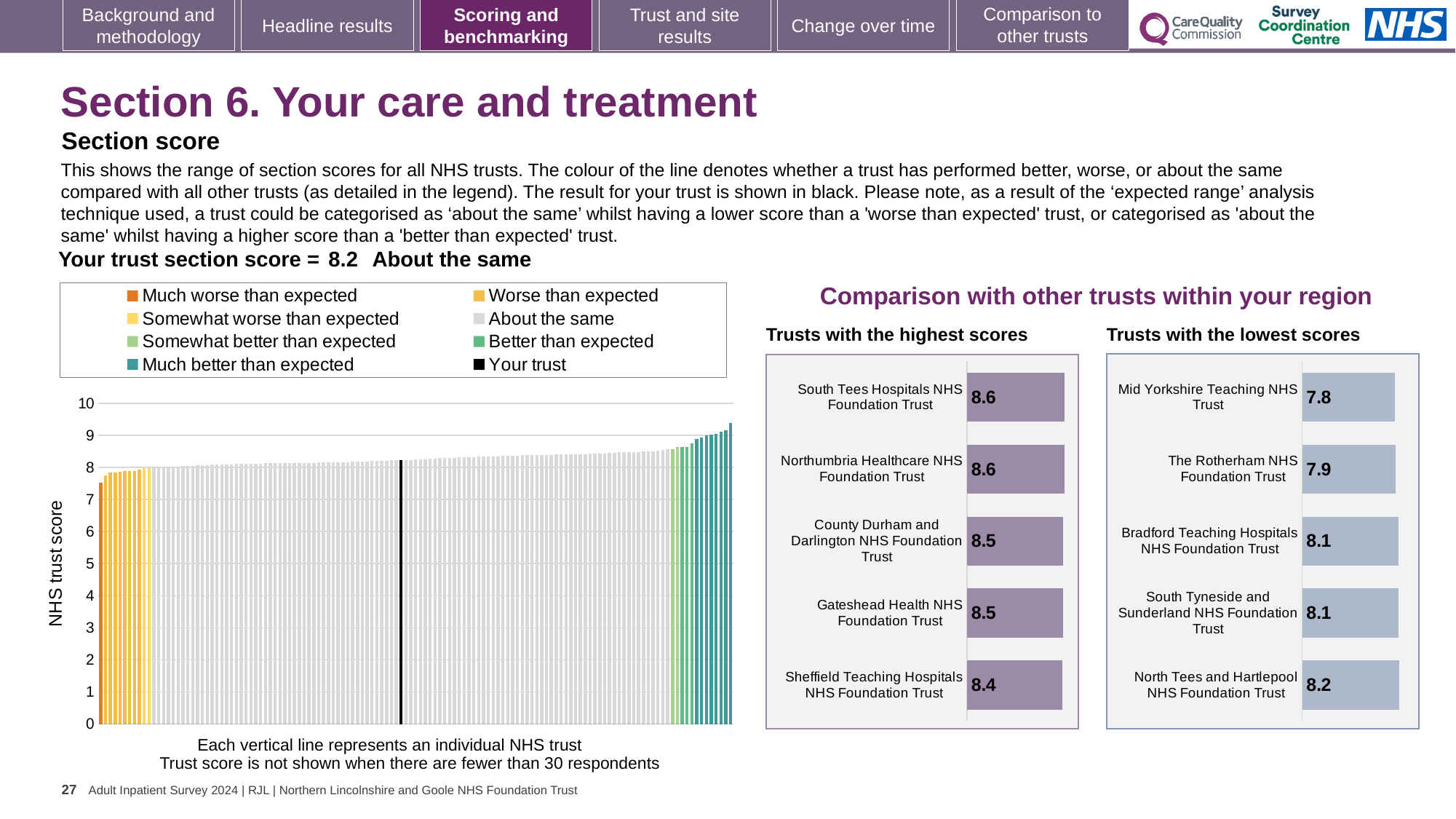
How many trusts are listed in the 'Trusts with the highest scores' chart? 5 What kind of chart is the 'Trusts with the lowest scores' chart? bar chart In the main chart on the left showing all NHS trusts, what is the section score for your trust? 8.2 In the 'Trusts with the highest scores' chart, what is the score for South Tees Hospitals NHS Foundation Trust? 8.6 In the 'Trusts with the lowest scores' chart, which has the larger score: The Rotherham NHS Foundation Trust or Mid Yorkshire Teaching NHS Trust? The Rotherham NHS Foundation Trust In the 'Trusts with the lowest scores' chart, what is the score for Mid Yorkshire Teaching NHS Trust? 7.8 In the 'Trusts with the highest scores' chart, what is the score for Sheffield Teaching Hospitals NHS Foundation Trust? 8.4 In the main chart on the left showing all NHS trusts, do the trust scores rise or fall from left to right? rise In the 'Trusts with the lowest scores' chart, which trust has the highest score? North Tees and Hartlepool NHS Foundation Trust In the 'Trusts with the highest scores' chart, what is the difference between the score for South Tees Hospitals NHS Foundation Trust and the score for Sheffield Teaching Hospitals NHS Foundation Trust? 0.2 In the 'Trusts with the lowest scores' chart, which trust has the lowest score? Mid Yorkshire Teaching NHS Trust How many entries does the legend of the main chart on the left list? 8